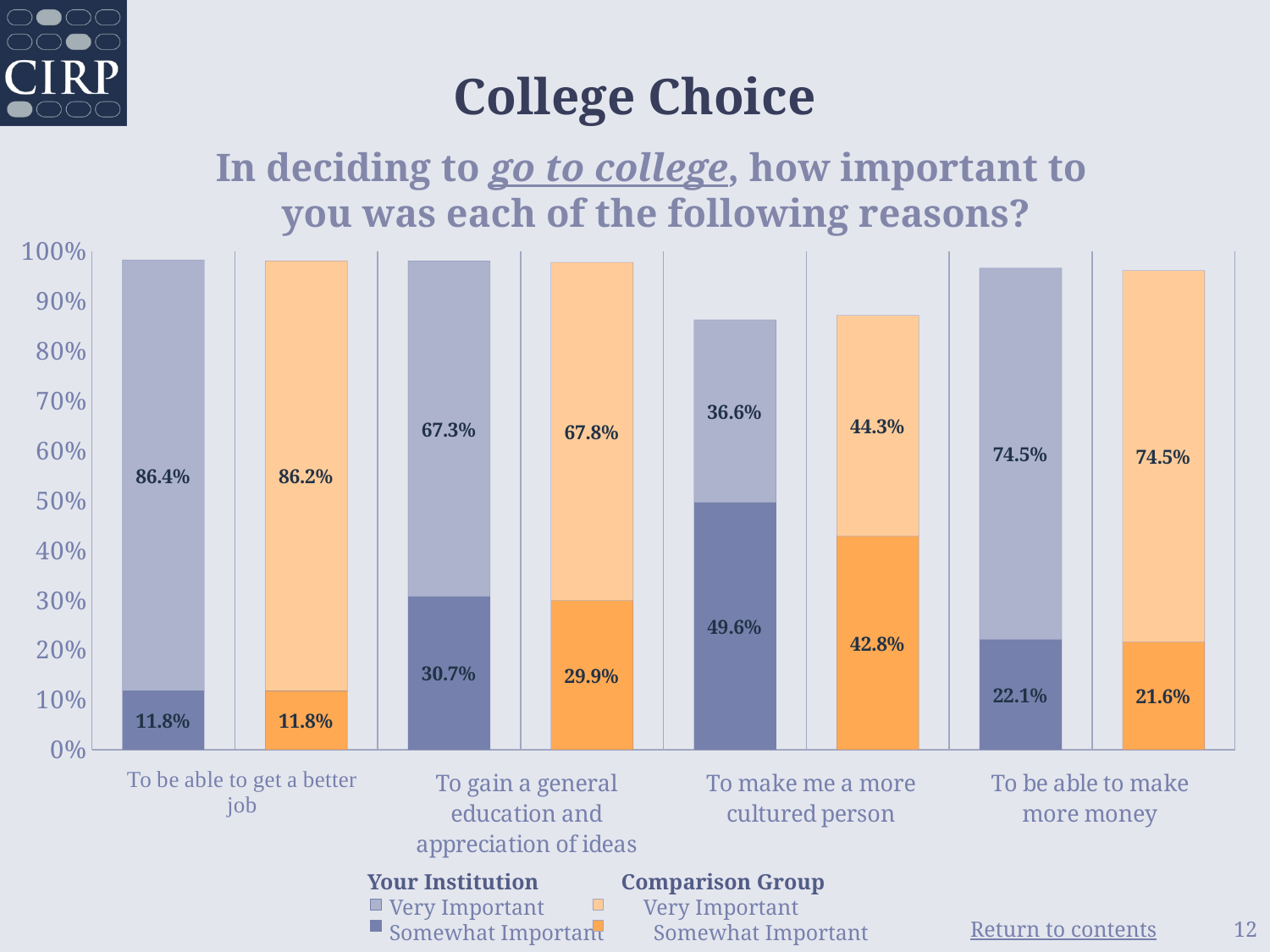
What is the combined Very Important and Somewhat Important total for the Comparison Group on 'To be able to make more money'? 96.1% What percentage of the Comparison Group rated 'To make me a more cultured person' as Somewhat Important? 42.8% What type of chart is shown on the slide? Stacked bar chart How many reasons (categories) are shown on the x axis of the chart? 4 What is the combined Very Important and Somewhat Important total for Your Institution on 'To make me a more cultured person'? 86.2% Which reason has the lowest Very Important percentage for the Comparison Group? To make me a more cultured person What is the Very Important percentage for 'To be able to make more money' in the Comparison Group? 74.5% For 'To gain a general education and appreciation of ideas', which is larger: the Very Important percentage for Your Institution or for the Comparison Group? Comparison Group How many entries does the chart legend list? 4 What is the difference between the Comparison Group and Your Institution Very Important percentages for 'To make me a more cultured person'? 7.7 percentage points What percentage of Your Institution respondents rated 'To be able to get a better job' as Very Important? 86.4% Which reason has the highest Very Important percentage for Your Institution? To be able to get a better job